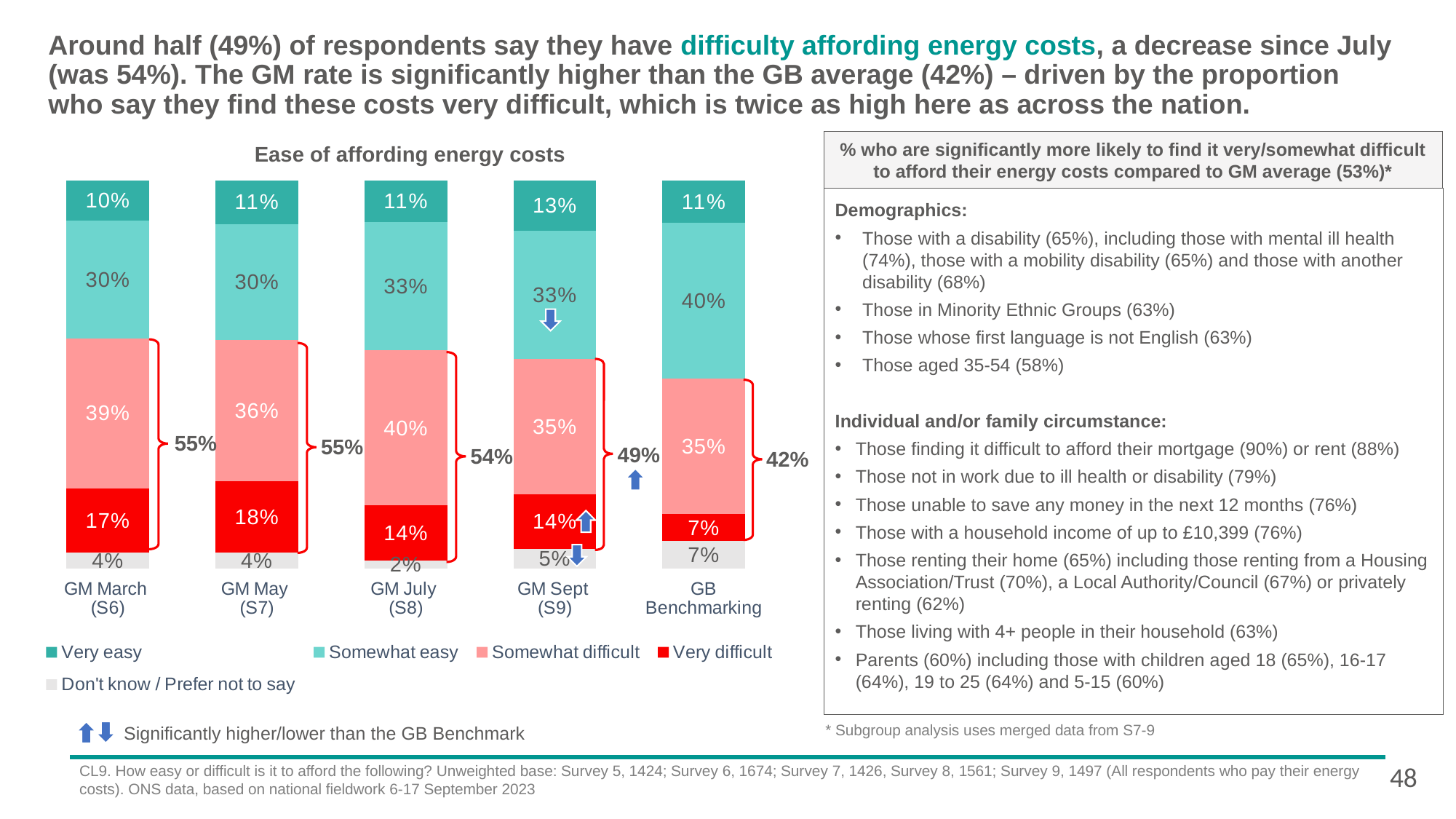
What is the 'Somewhat difficult' value for GM July (S8)? 40% What is the difference between the 'Very difficult' values for GM Sept (S9) and GB Benchmarking? 7% What kind of chart is shown on the slide? Stacked bar chart How many bars (categories) are shown in the chart? 5 Which category has the lowest 'Very difficult' value? GB Benchmarking What is the combined 'Somewhat difficult' plus 'Very difficult' total shown for GM Sept (S9)? 49% What is the 'Somewhat easy' value for GB Benchmarking? 40% How many series does the legend list? 5 What percentage of respondents in GM Sept (S9) said affording energy costs was very difficult? 14% Which category has the highest 'Very difficult' value? GM May (S7) Which is larger, the 'Somewhat easy' value for GM March (S6) or for GB Benchmarking? GB Benchmarking What is the title of the chart? Ease of affording energy costs